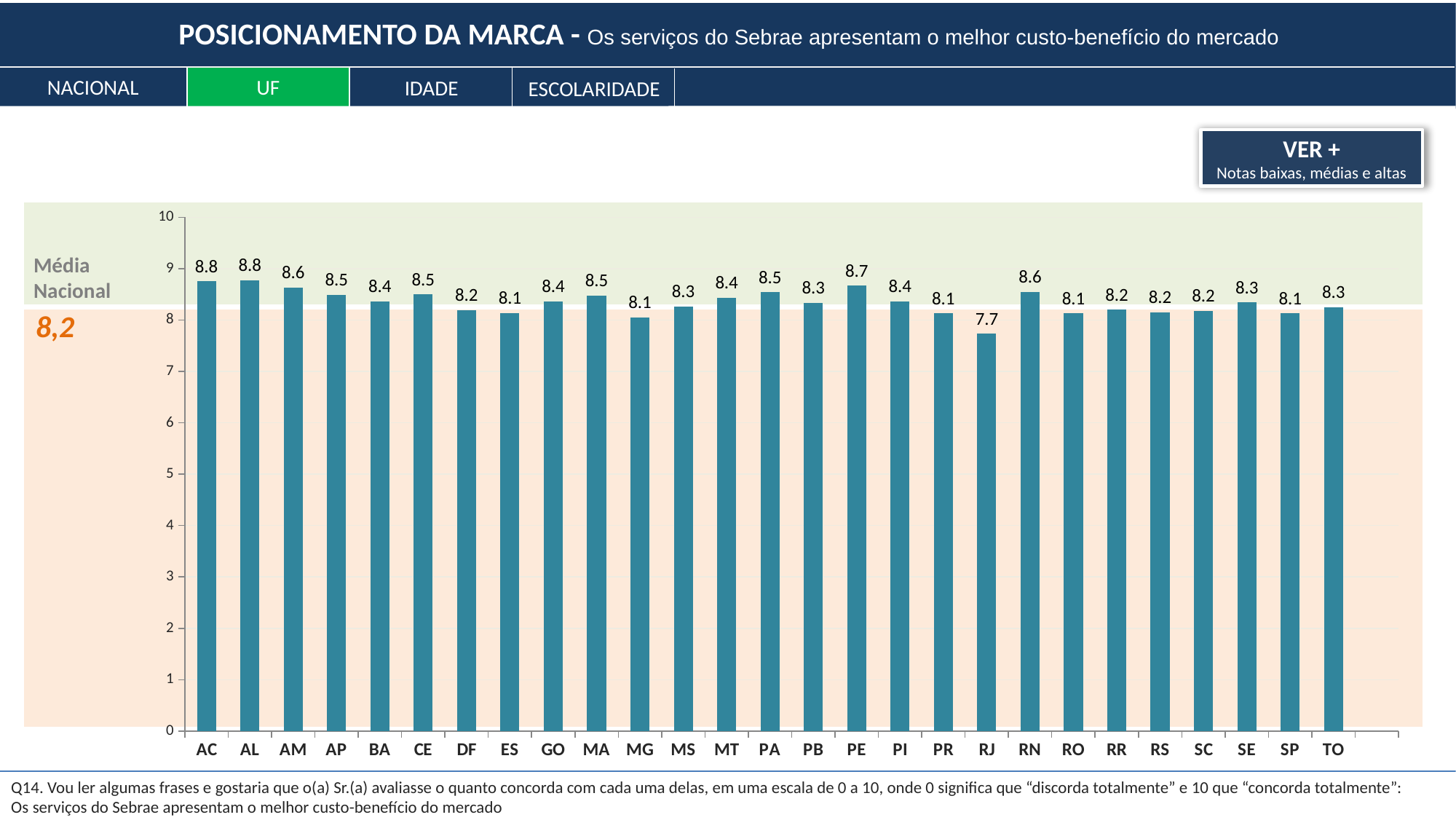
How many states (UFs) are shown on the x axis? 27 Which state has the lowest value? RJ What is the Média Nacional value shown on the chart? 8,2 What is the difference between the values for AC and DF? 0.6 What is the value for TO? 8.3 What is the value for RJ? 7.7 What is the value for PE? 8.7 Is the value for RJ greater or less than 8? less What is the difference between the values for PE and RJ? 1.0 Which has a larger value, AM or MG? AM What kind of chart is shown on the slide? bar chart Which has a larger value, RN or SP? RN